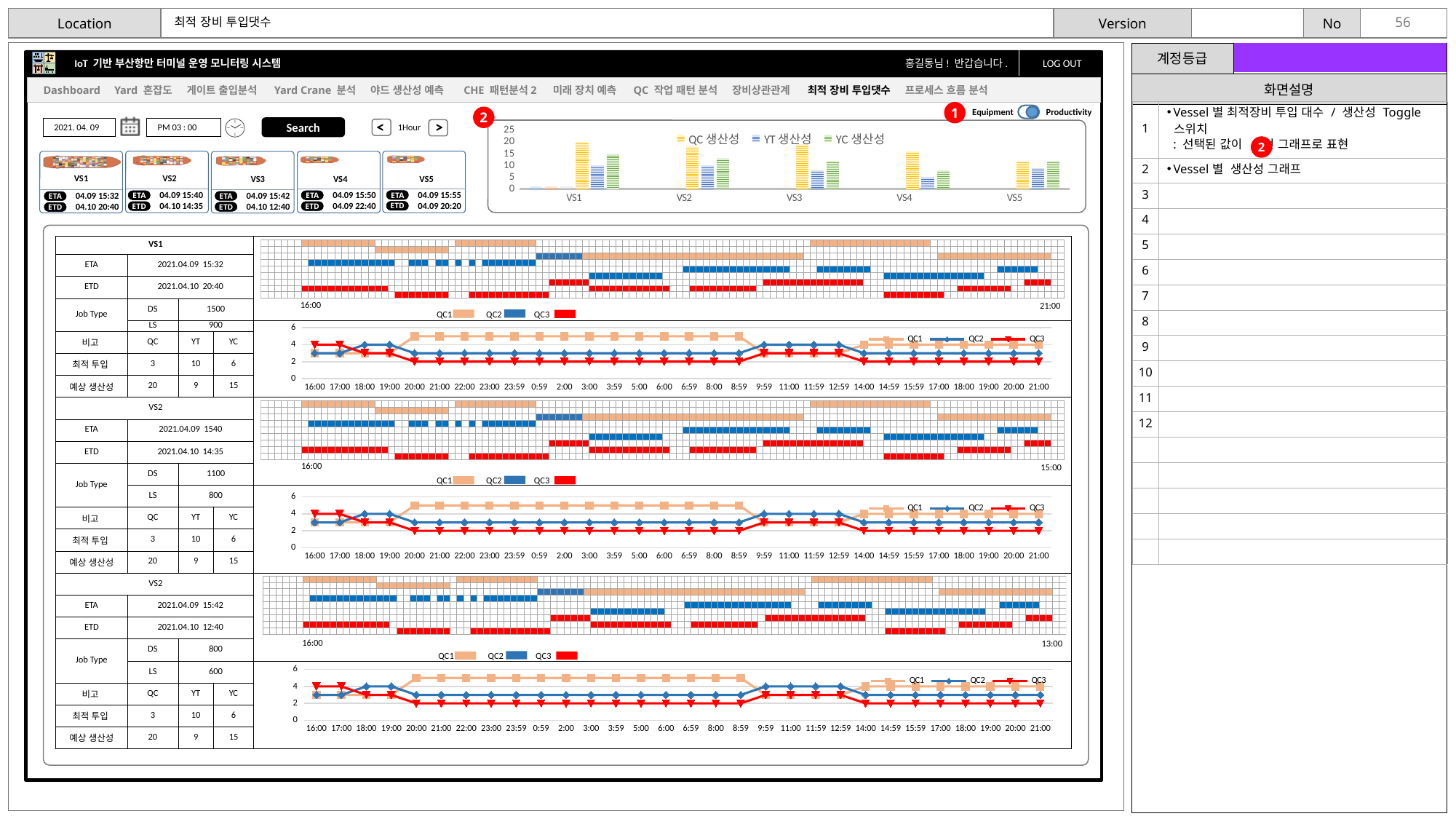
What kind of chart is the first chart below the VS1 table, showing QC1, QC2 and QC3 over time? line chart In the top bar chart, is the QC 생산성 value for VS1 greater or less than 15? greater In the top bar chart, is the YT 생산성 value for VS1 greater or less than 15? less What kind of chart is the chart at the top of the dashboard showing QC 생산성, YT 생산성 and YC 생산성? bar chart In the top bar chart, is the YT 생산성 value for VS4 greater or less than 10? less How many vessel categories are shown on the x axis of the top bar chart? 5 In the top bar chart, which vessel has the lowest YT 생산성? VS4 In the top bar chart, which series has the highest value for VS3: QC 생산성, YT 생산성 or YC 생산성? QC 생산성 In the top bar chart, is the QC 생산성 value for VS2 larger or smaller than the YT 생산성 value for VS2? larger How many series does the legend of the top bar chart list? 3 In the first line chart (below the VS1 table), does the QC3 line rise or fall between 16:00 and 20:00? fall